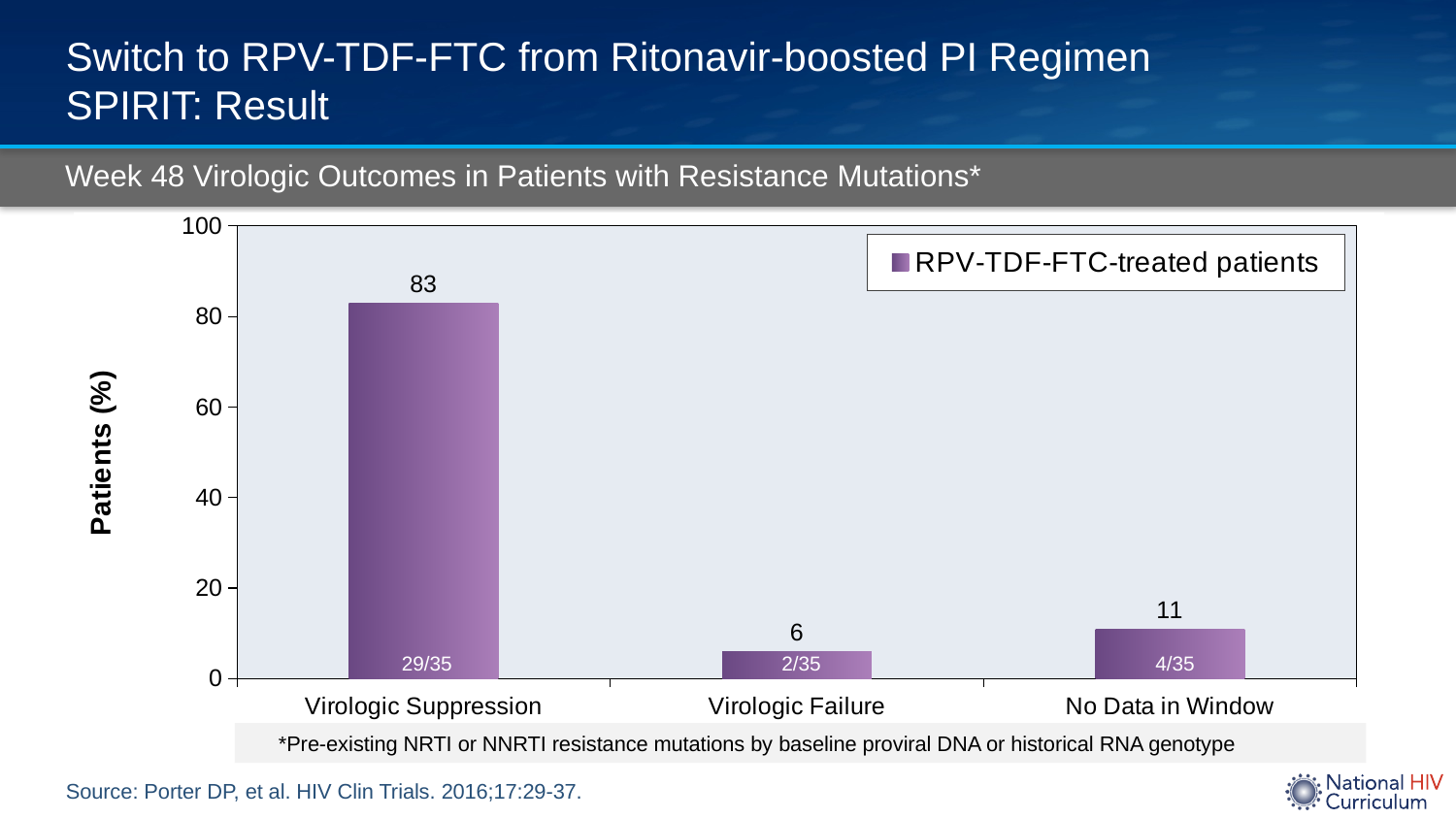
Which is larger, the value for Virologic Failure or the value for No Data in Window? No Data in Window What is the difference in percentage points between Virologic Suppression and No Data in Window? 72 What percentage of patients had Virologic Failure? 6 How many series does the legend list? 1 What kind of chart is shown? Bar chart Which category has the highest value? Virologic Suppression Which category has the lowest value? Virologic Failure What percentage of patients achieved Virologic Suppression? 83 What percentage of patients had No Data in Window? 11 How many categories are shown on the x axis? 3 Is the value for Virologic Suppression greater or less than 80? greater What fraction is printed inside the Virologic Suppression bar? 29/35